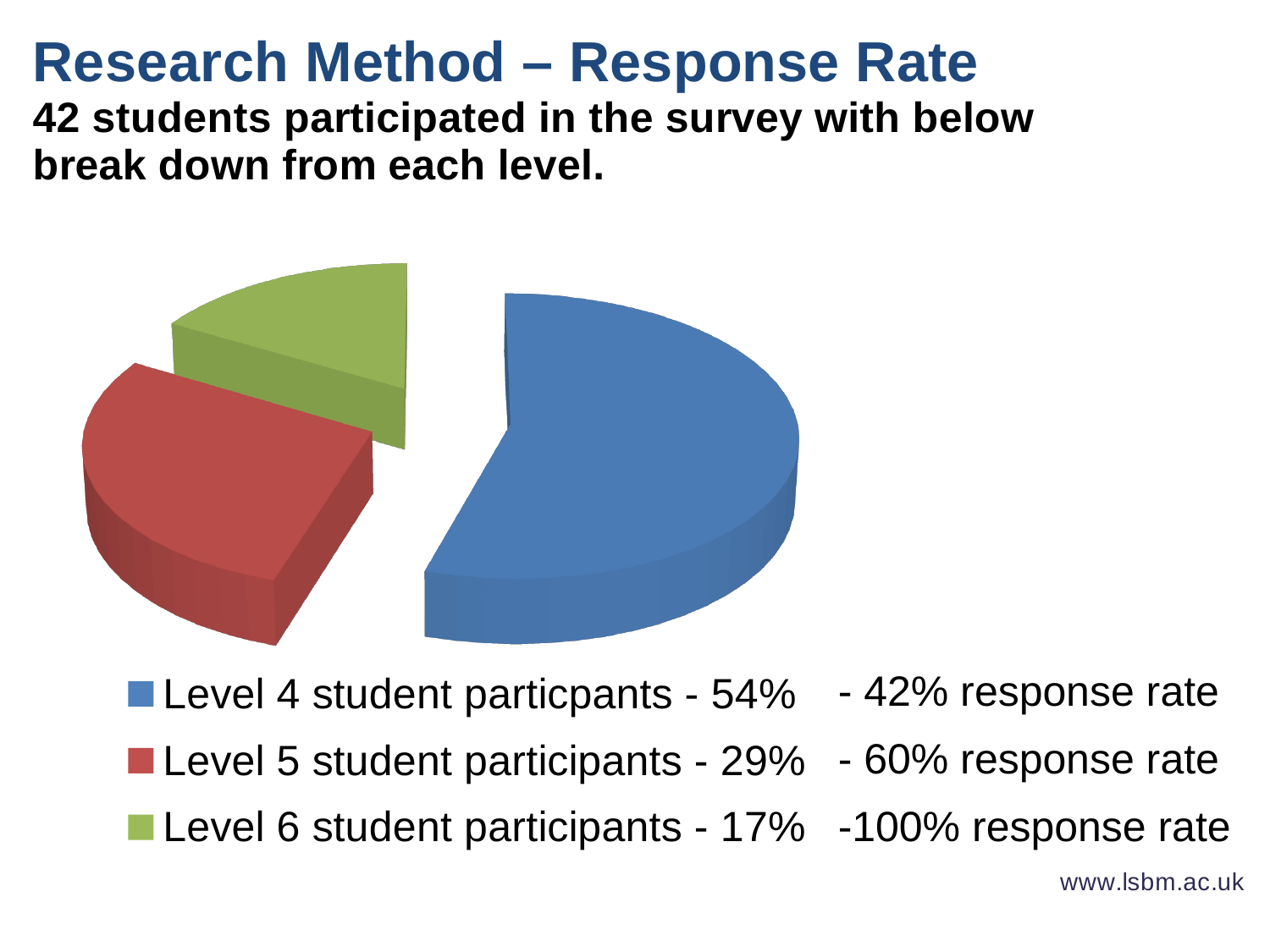
What is the difference in percentage points between the Level 4 and Level 5 shares? 25 What response rate is listed for Level 6 students in the legend? 100% What share of participants were Level 5 students, according to the legend? 29% What share of participants were Level 4 students, according to the legend? 54% What kind of chart is shown on the slide? pie chart Which level has the smallest slice of the pie? Level 6 student participants Which level has the largest slice of the pie? Level 4 student participants What share of participants were Level 6 students, according to the legend? 17% What colour is the slice for Level 5 student participants? red How many students participated in the survey, according to the slide? 42 How many slices does the pie chart have? 3 Which slice is larger: Level 5 or Level 6 student participants? Level 5 student participants